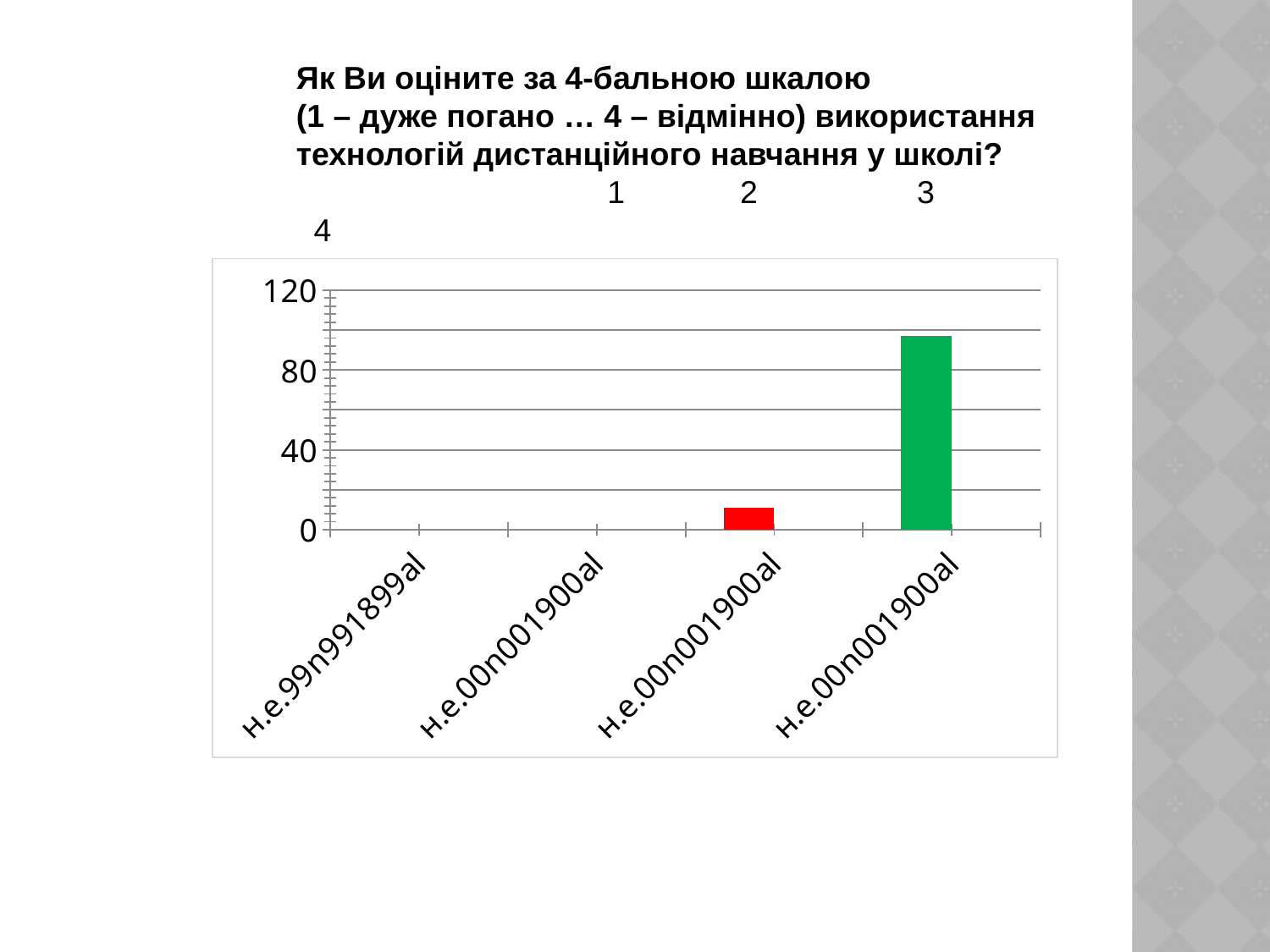
What colour is the tallest bar in the chart? green What kind of chart is shown on the slide? bar chart Is the value of the green bar greater or less than 80? greater Which is larger, the green bar or the red bar? the green bar Is the value of the green bar greater or less than 120? less How many bars with a visible height are plotted in the chart? 2 Is the value of the red bar greater or less than 40? less How many categories are marked along the x axis of the chart? 4 What is the highest value labelled on the y axis of the chart? 120 Which bar in the chart is the tallest? the green bar (rightmost)